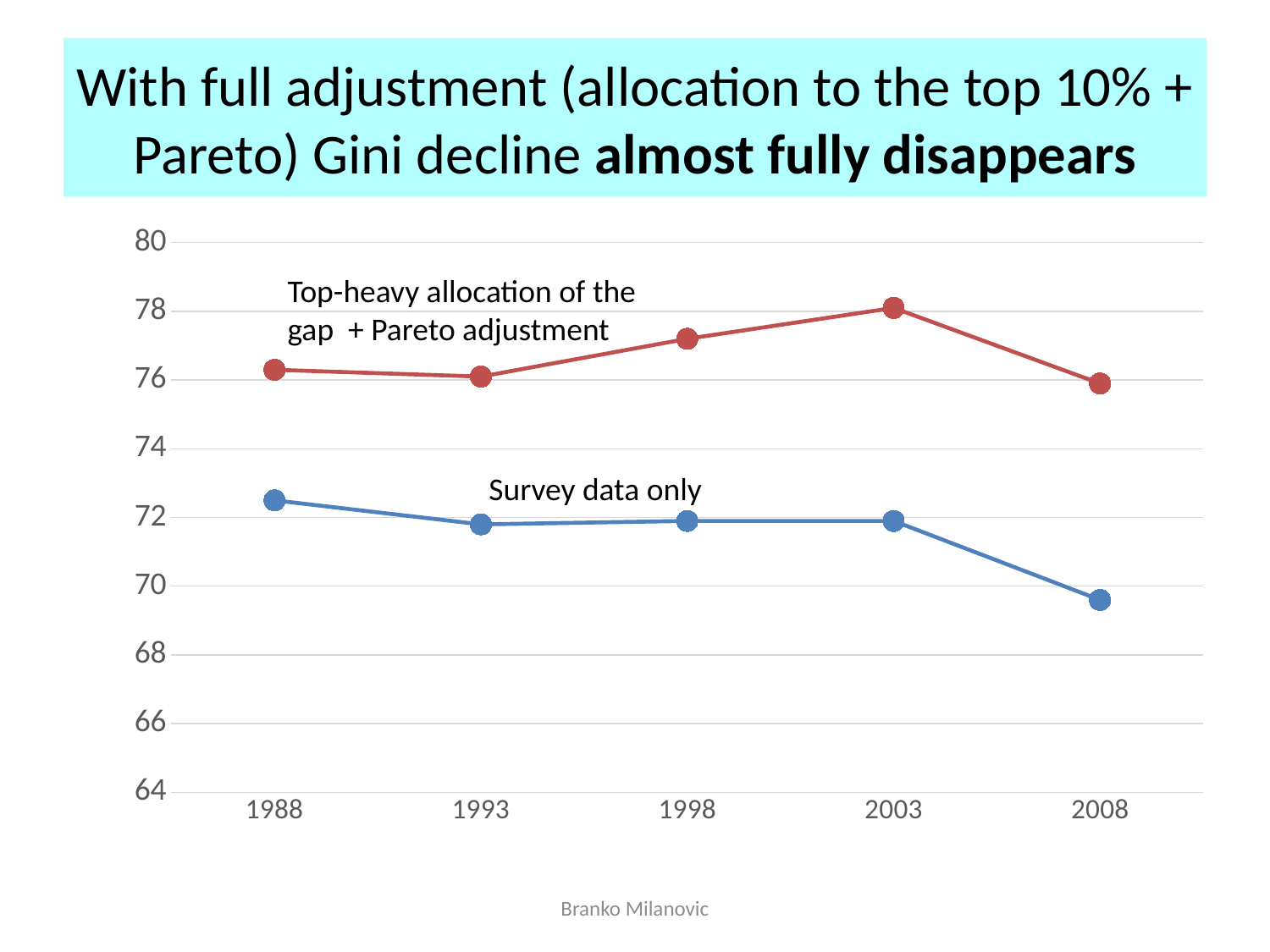
Which series has the higher value in 1998, 'Survey data only' or 'Top-heavy allocation of the gap + Pareto adjustment'? Top-heavy allocation of the gap + Pareto adjustment How many years are plotted along the x axis? 5 How many lines (series) are plotted on the chart? 2 Is the 'Top-heavy allocation of the gap + Pareto adjustment' value for 2003 greater or less than 76? greater Is the 'Survey data only' value for 2008 greater or less than 70? less In which year does the 'Survey data only' series reach its highest value? 1988 What kind of chart is shown on the slide? line chart In which year does the 'Top-heavy allocation of the gap + Pareto adjustment' series reach its highest value? 2003 Does the 'Survey data only' series rise or fall between 2003 and 2008? fall In which year does the 'Survey data only' series reach its lowest value? 2008 Is the 'Survey data only' value for 1988 greater or less than 72? greater What colour is the line for the 'Survey data only' series? blue